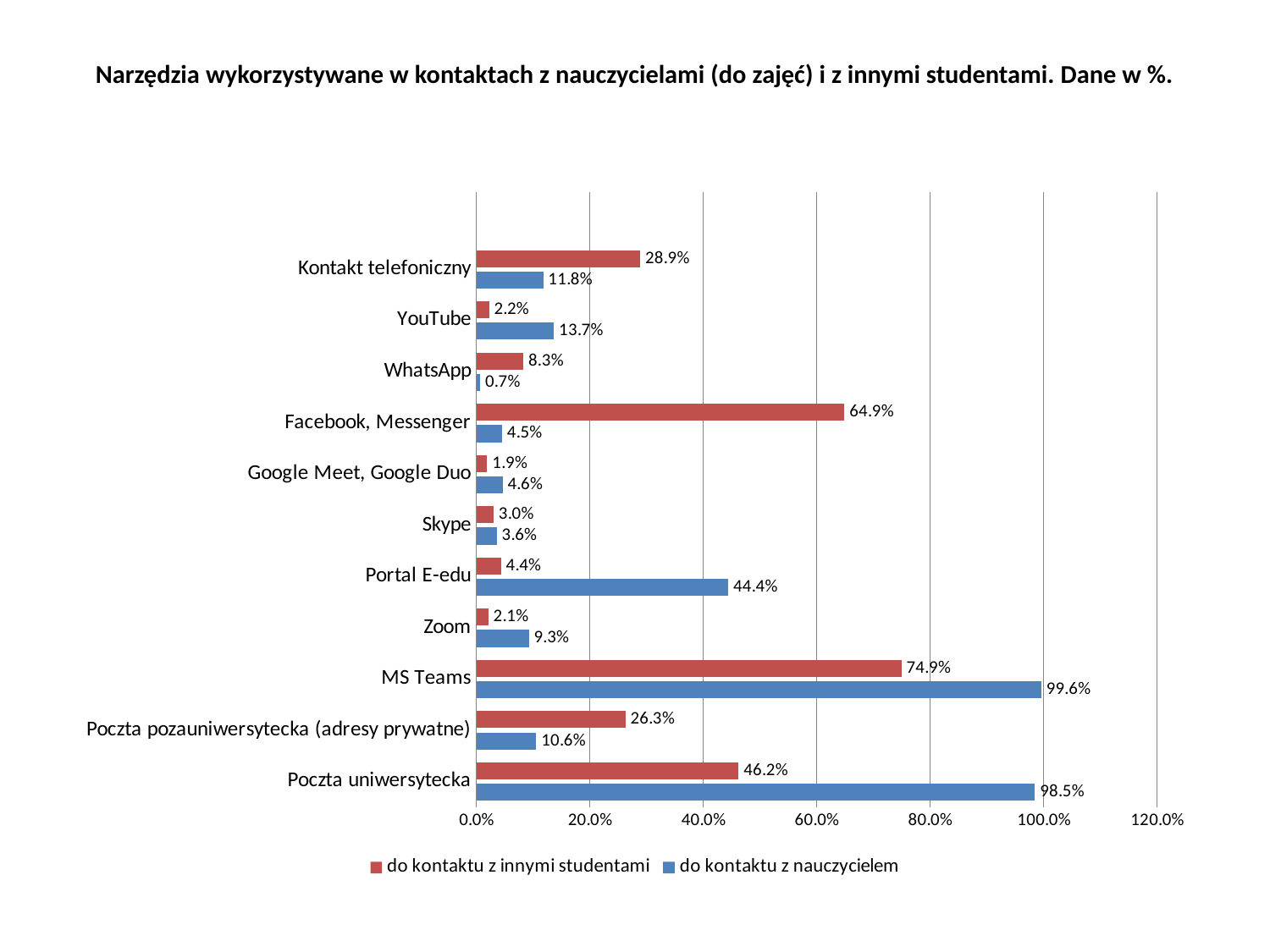
What is the difference between the 'do kontaktu z nauczycielem' and 'do kontaktu z innymi studentami' values for MS Teams? 24.7 percentage points What kind of chart is shown on the slide? Bar chart How many tools (categories) are shown on the chart? 11 What is the value for Portal E-edu in the 'do kontaktu z nauczycielem' series? 44.4% For Kontakt telefoniczny, which series has the larger value: 'do kontaktu z innymi studentami' or 'do kontaktu z nauczycielem'? do kontaktu z innymi studentami Which tool has the lowest value in the 'do kontaktu z nauczycielem' series? WhatsApp Which tool has the highest value in the 'do kontaktu z nauczycielem' series? MS Teams What is the value for Facebook, Messenger in the 'do kontaktu z innymi studentami' series? 64.9% How many series does the legend list? 2 Which tool has the highest value in the 'do kontaktu z innymi studentami' series? MS Teams Is the 'do kontaktu z nauczycielem' value for Poczta uniwersytecka greater or less than 80.0%? greater What is the value for MS Teams in the 'do kontaktu z nauczycielem' series? 99.6%